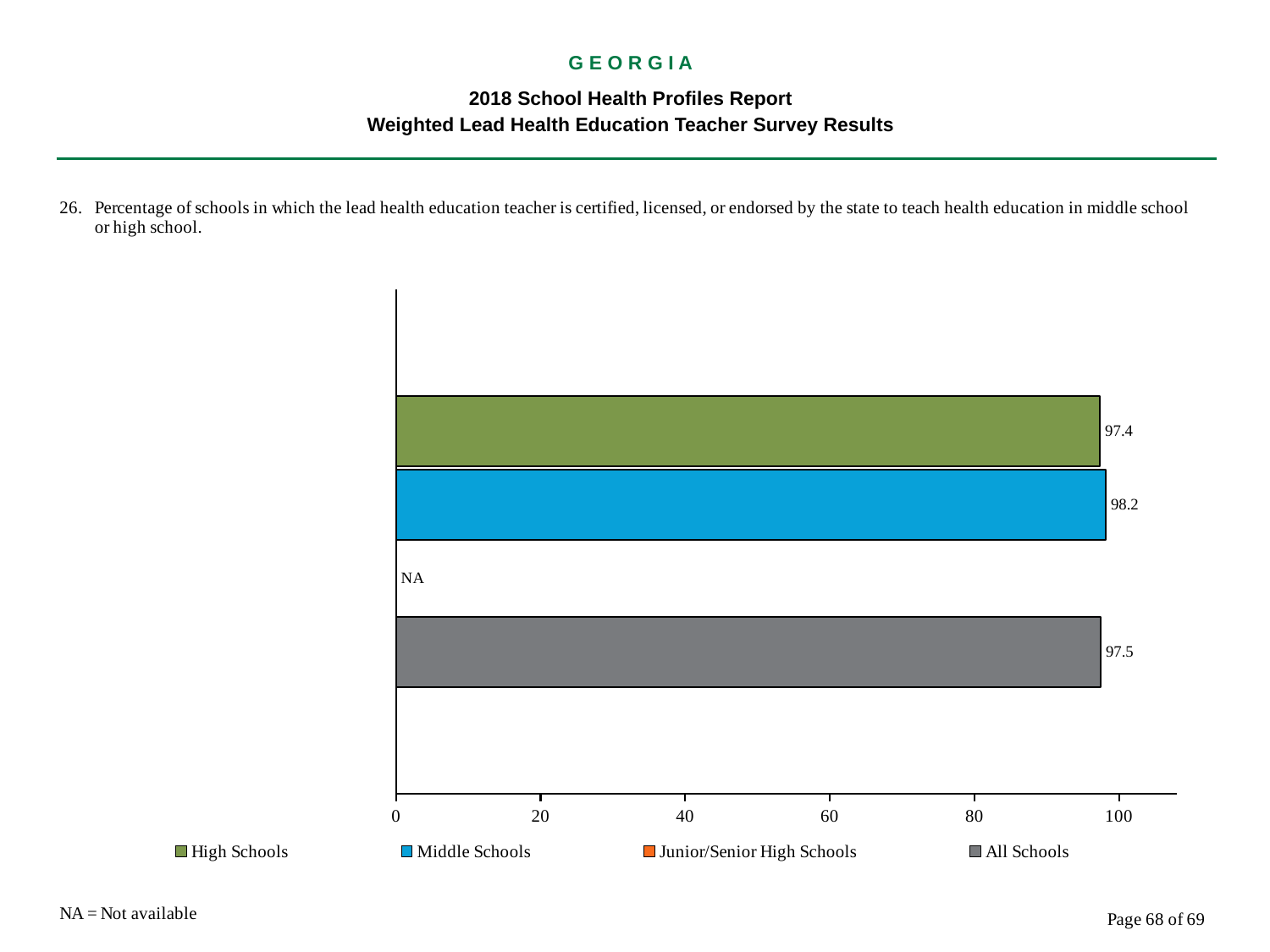
What is the difference between the Middle Schools value and the High Schools value? 0.8 Which school type has the highest value? Middle Schools What is the value for Middle Schools? 98.2 What kind of chart is this? bar chart What is shown for Junior/Senior High Schools? NA What is the difference between the All Schools value and the High Schools value? 0.1 Is the value for Middle Schools greater or less than 80? greater What is the value for All Schools? 97.5 What is the value for High Schools? 97.4 What does NA stand for according to the slide? Not available How many series does the legend list? 4 What colour is the Middle Schools bar? blue